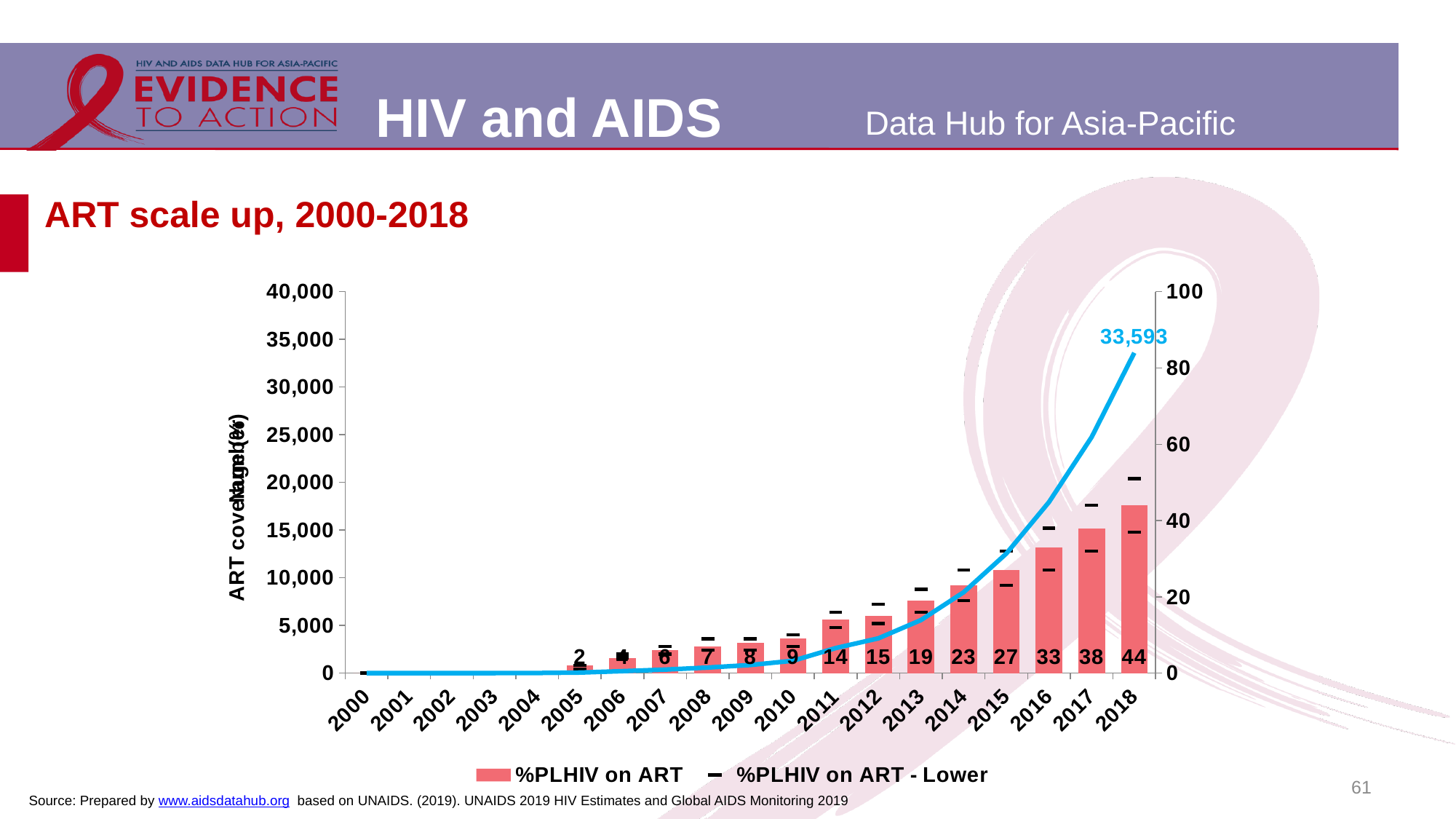
What is the %PLHIV on ART value labelled for 2011? 14 What is the difference between the %PLHIV on ART values for 2018 and 2017? 6 What is the title of the chart? ART scale up, 2000-2018 What is the %PLHIV on ART value labelled for 2018? 44 Which year has the larger %PLHIV on ART value, 2014 or 2012? 2014 How many years are shown on the x axis? 19 Is the value of the blue line in 2018 greater or less than 30,000 on the left axis? greater Do the %PLHIV on ART bars rise or fall from 2005 to 2018? rise What is the difference between the %PLHIV on ART values for 2015 and 2013? 8 What is the %PLHIV on ART value labelled for 2016? 33 What value is labelled at the end of the blue line in 2018? 33,593 Which year has the highest %PLHIV on ART bar? 2018